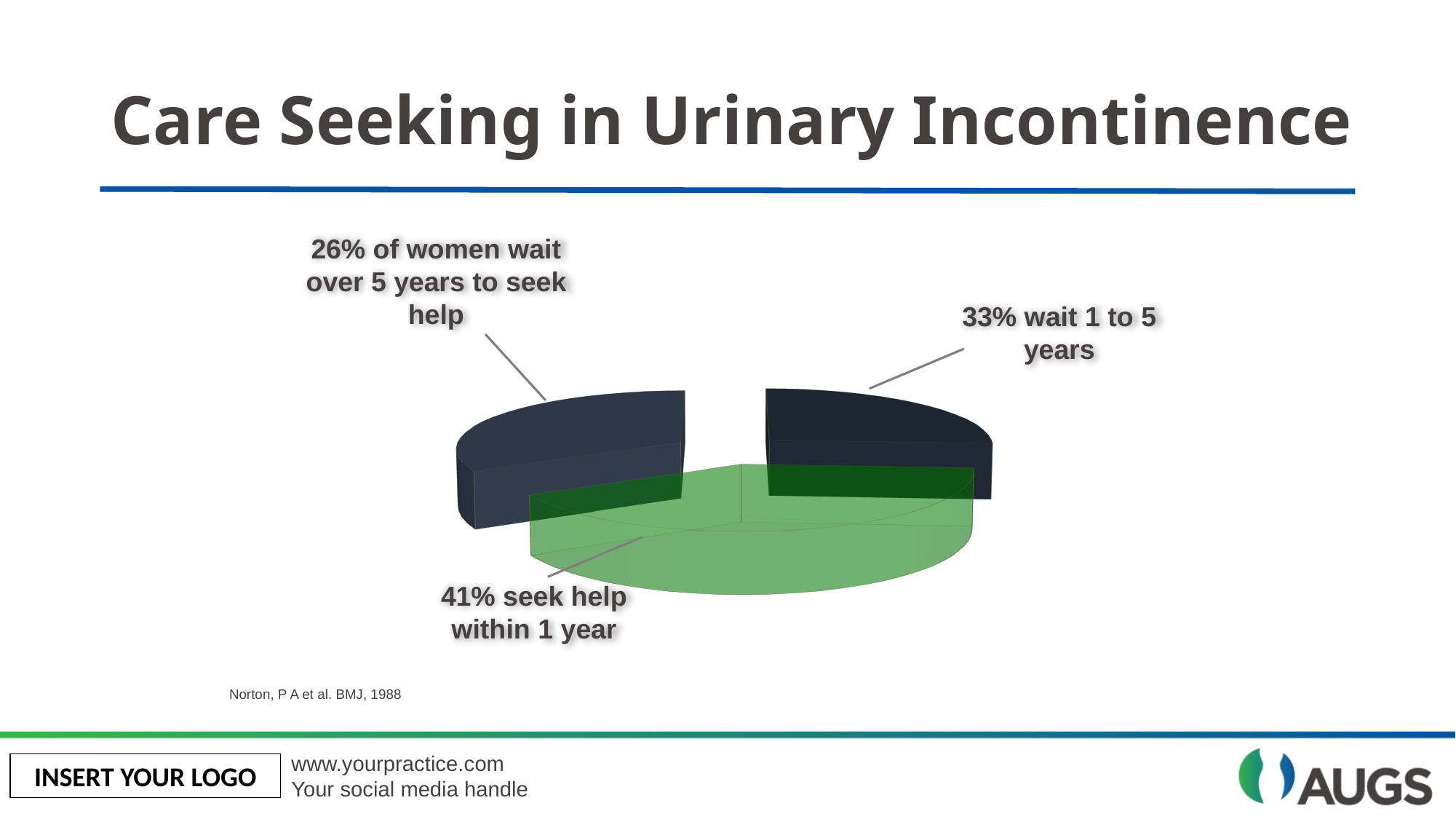
What percentage of women wait 1 to 5 years to seek help? 33% What is the difference in percentage points between women who wait 1 to 5 years and those who wait over 5 years? 7 What colour is the slice for women who seek help within 1 year? Green What is the difference in percentage points between women who seek help within 1 year and those who wait over 5 years? 15 Which is larger: the share of women who wait 1 to 5 years or the share who wait over 5 years? Wait 1 to 5 years Which group makes up the largest share of the pie? Seek help within 1 year How many slices does the pie chart have? 3 What percentage of women seek help within 1 year? 41% Which group makes up the smallest share of the pie? Wait over 5 years to seek help What percentage of women wait over 5 years to seek help? 26% What kind of chart is shown on the slide? Pie chart What is the title of the slide containing the chart? Care Seeking in Urinary Incontinence